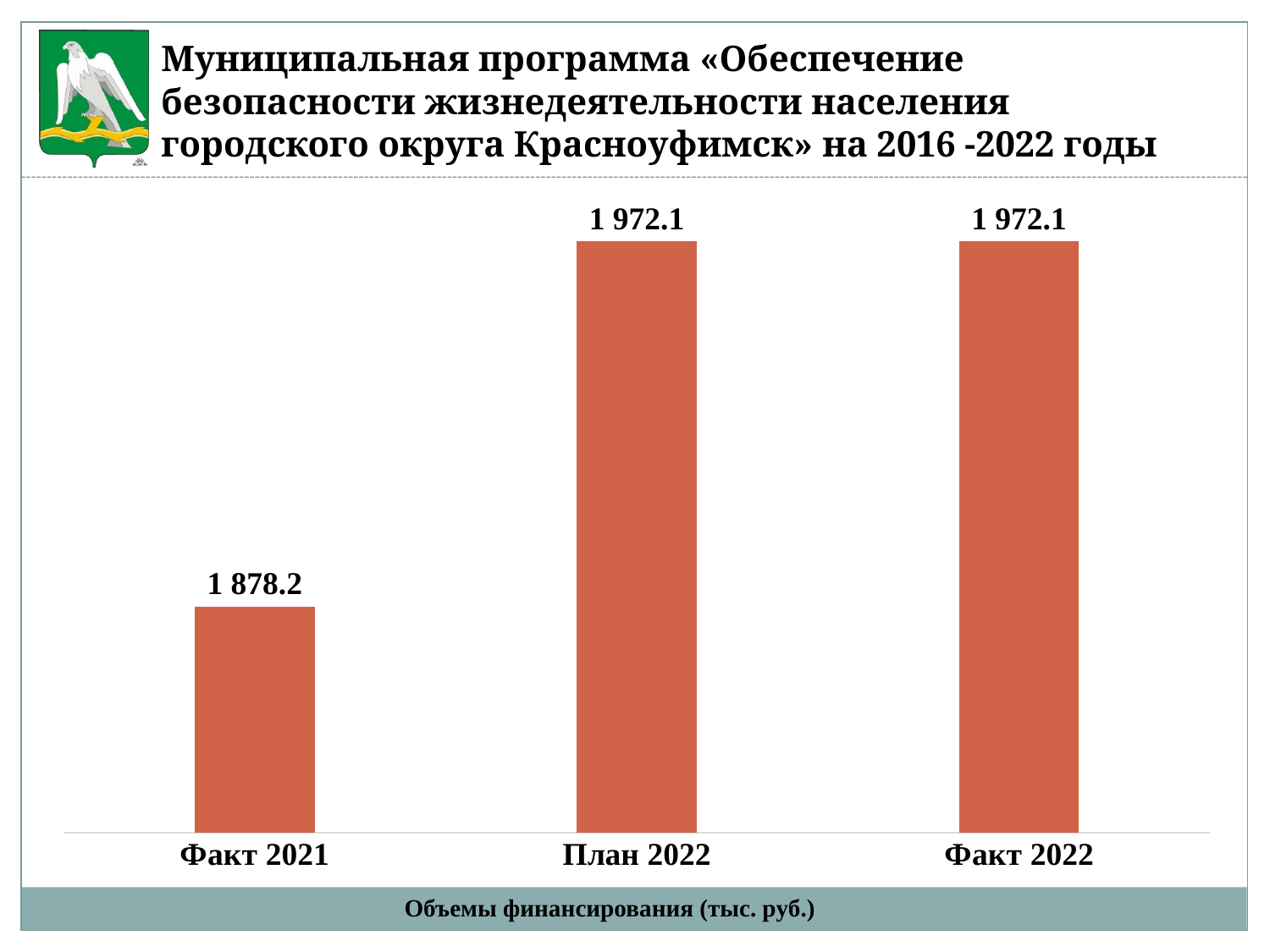
What is the value for Факт 2021? 1 878.2 What is the value for Факт 2022? 1 972.1 Which is larger, the value for Факт 2021 or the value for План 2022? План 2022 Which category has the lowest value? Факт 2021 What is the value for План 2022? 1 972.1 What kind of chart is shown on the slide? Bar chart What colour are the bars in the chart? Orange-red What caption is shown beneath the chart? Объемы финансирования (тыс. руб.) What is the difference between the values for План 2022 and Факт 2021? 93.9 Are the values for План 2022 and Факт 2022 equal? Yes How many bars are shown in the chart? 3 Does the value rise or fall from Факт 2021 to План 2022? Rise